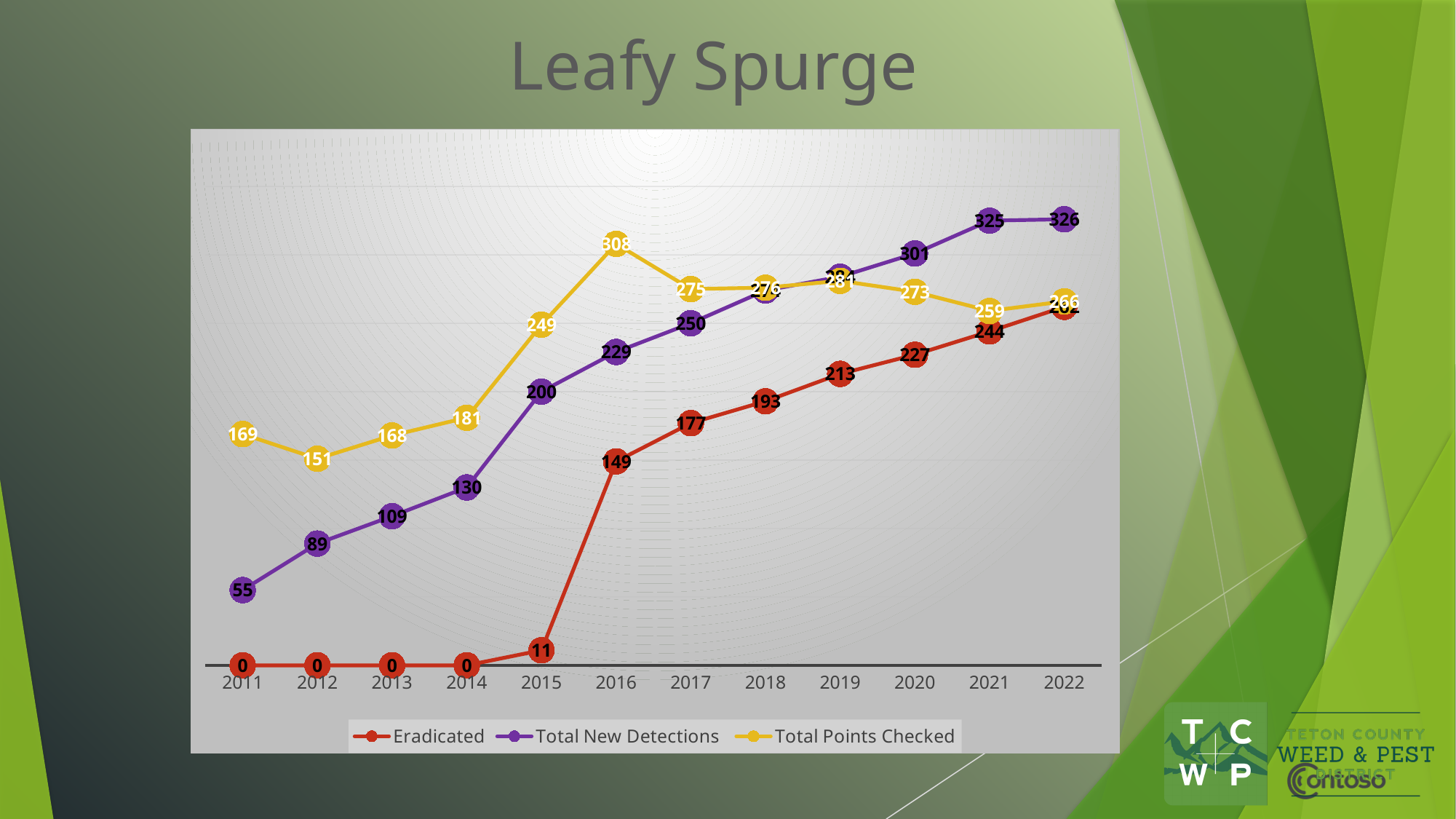
What is the Total Points Checked value for 2016? 308 In 2017, which is larger: Total Points Checked or Total New Detections? Total Points Checked In which year is Total Points Checked highest? 2016 How many years are plotted along the x axis? 12 In which year is Total New Detections lowest? 2011 What is the Eradicated value for 2016? 149 How many series does the legend list? 3 Does the Total New Detections series rise or fall from 2011 to 2022? rise What is the Eradicated value for 2021? 244 What kind of chart is shown on the slide? line chart What is the difference between Total New Detections in 2022 and in 2011? 271 What is the Total New Detections value for 2015? 200